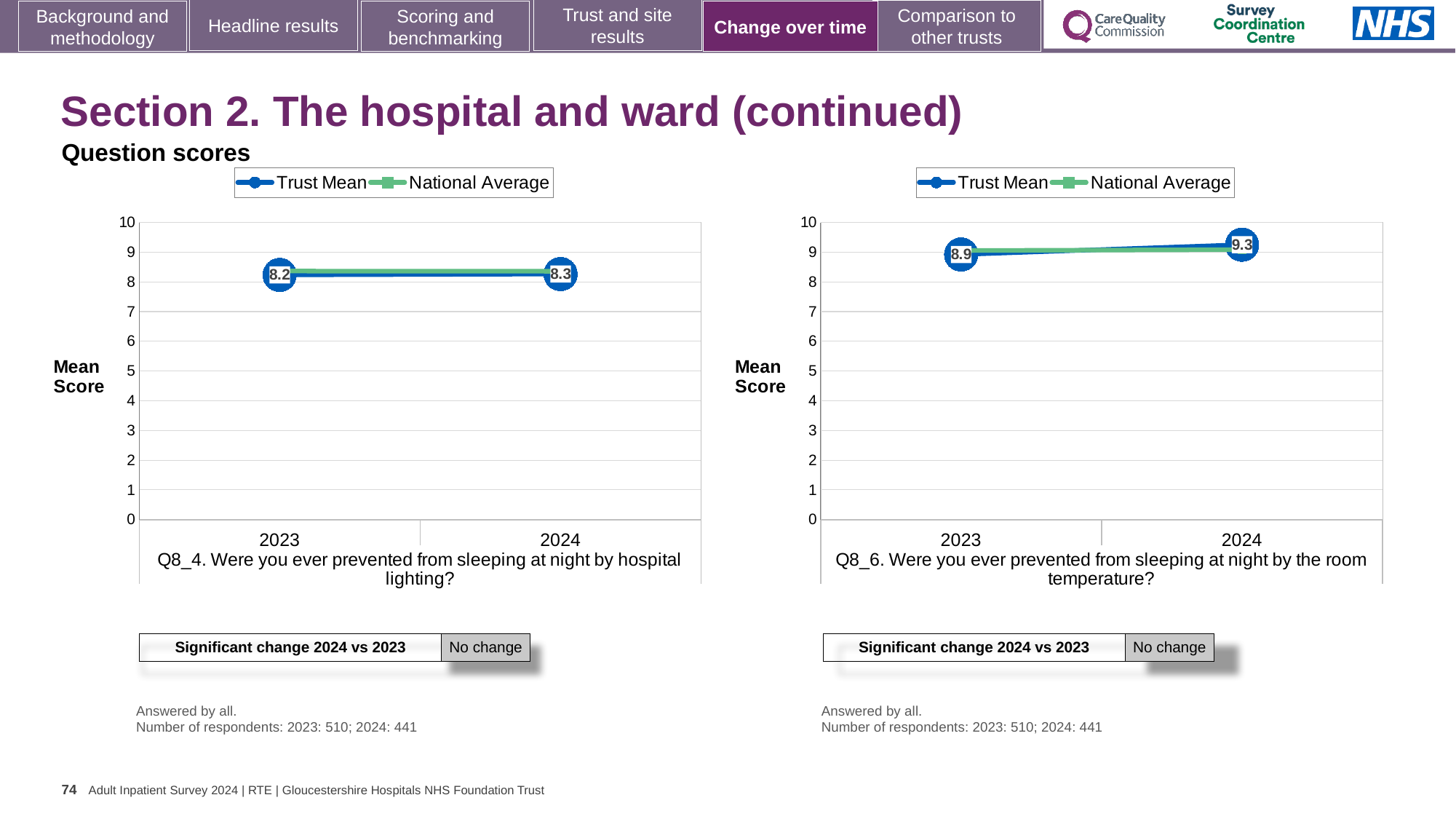
In the Q8_4 chart (left), what is the Trust Mean score for 2024? 8.3 How many series does the legend of the Q8_4 chart (left) list? 2 What type of chart is used for Q8_4 (left)? line chart In the Q8_6 chart (right), which year has the higher Trust Mean score? 2024 In the Q8_4 chart (left), what is the difference between the Trust Mean for 2024 and 2023? 0.1 In the Q8_4 chart (left), what is the Trust Mean score for 2023? 8.2 In the Q8_6 chart (right), what is the Trust Mean score for 2023? 8.9 In the Q8_4 chart (left), is the National Average for 2023 greater or less than 5? greater In the Q8_6 chart (right), by how much did the Trust Mean change from 2023 to 2024? 0.4 How many years are plotted on the x axis of the Q8_6 chart (right)? 2 In the Q8_6 chart (right), what is the Trust Mean score for 2024? 9.3 In the Q8_6 chart (right), does the Trust Mean rise or fall from 2023 to 2024? rise